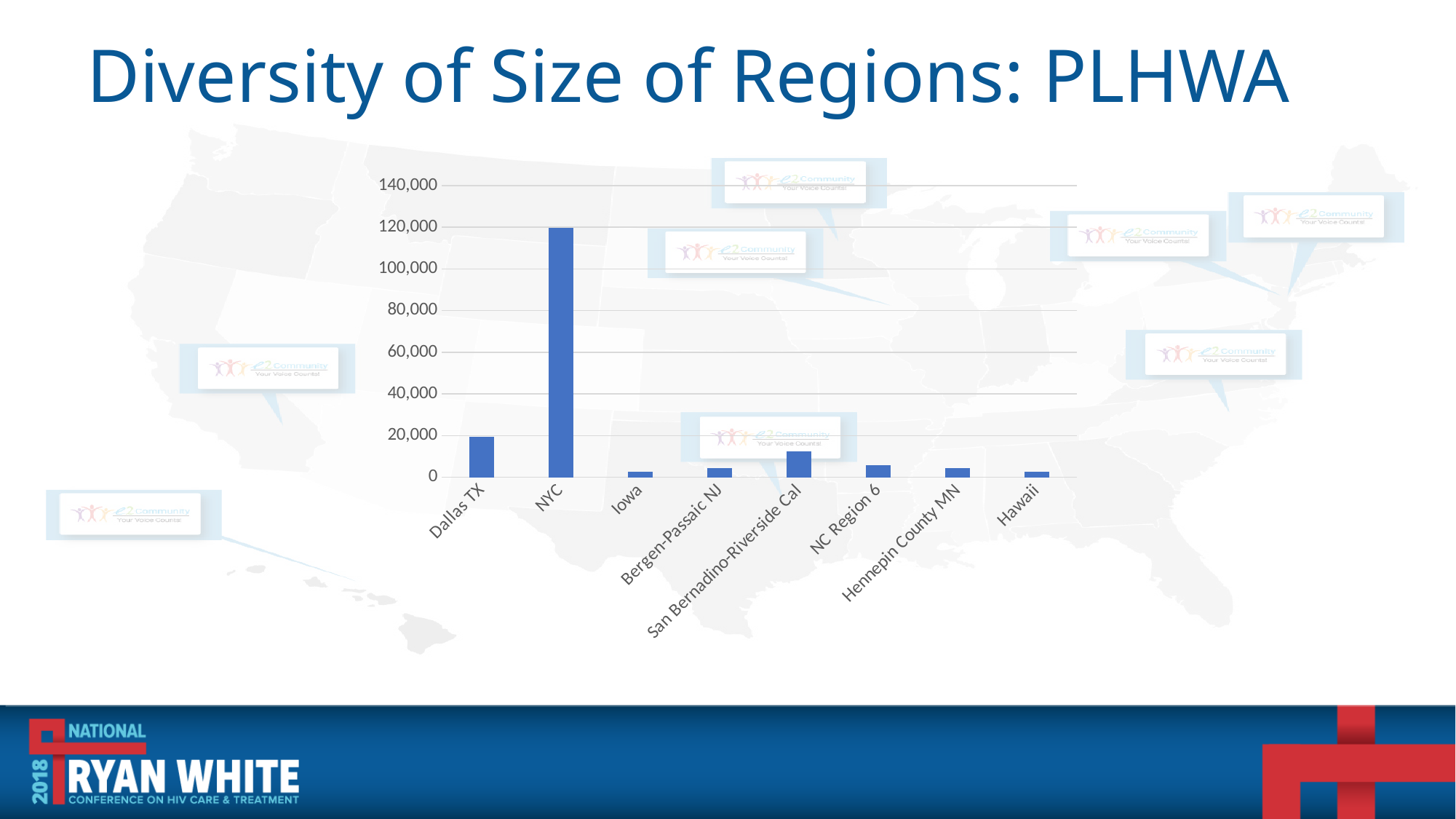
Is the value for NYC greater or less than 100,000? greater Which is larger, the value for NYC or the value for Dallas TX? NYC Which is larger, the value for San Bernadino-Riverside Cal or the value for NC Region 6? San Bernadino-Riverside Cal What is the title of the slide containing the chart? Diversity of Size of Regions: PLHWA What is the highest value shown on the chart's vertical axis? 140,000 What kind of chart is shown on the slide? Bar chart Which is larger, the value for Dallas TX or the value for San Bernadino-Riverside Cal? Dallas TX How many regions are plotted on the chart? 8 Is the value for San Bernadino-Riverside Cal greater or less than 20,000? less Is the value for Dallas TX greater or less than 40,000? less Which region has the highest value on the chart? NYC